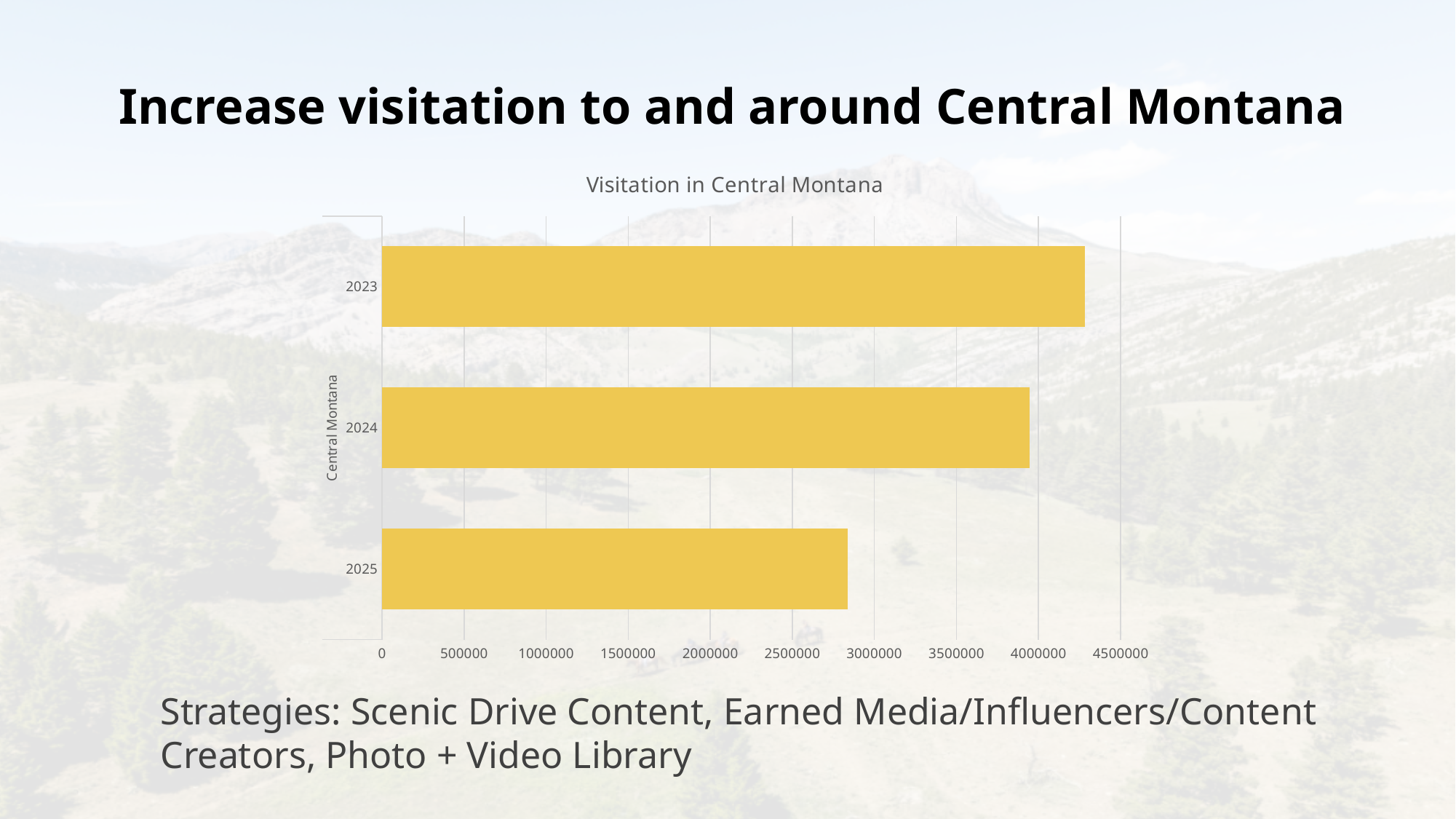
Is the value for 2024 greater or less than 3500000? greater What is the label on the vertical axis of the chart? Central Montana Is the value for 2025 greater or less than 3000000? less How many years are plotted in the chart? 3 What is the title of the chart? Visitation in Central Montana Is the value for 2023 greater or less than 4000000? greater Which year has a larger visitation value, 2024 or 2025? 2024 What kind of chart is shown on the slide? Bar chart Which year has the highest visitation in the chart? 2023 Do the visitation values rise or fall from 2023 to 2025? fall Which year has the lowest visitation in the chart? 2025